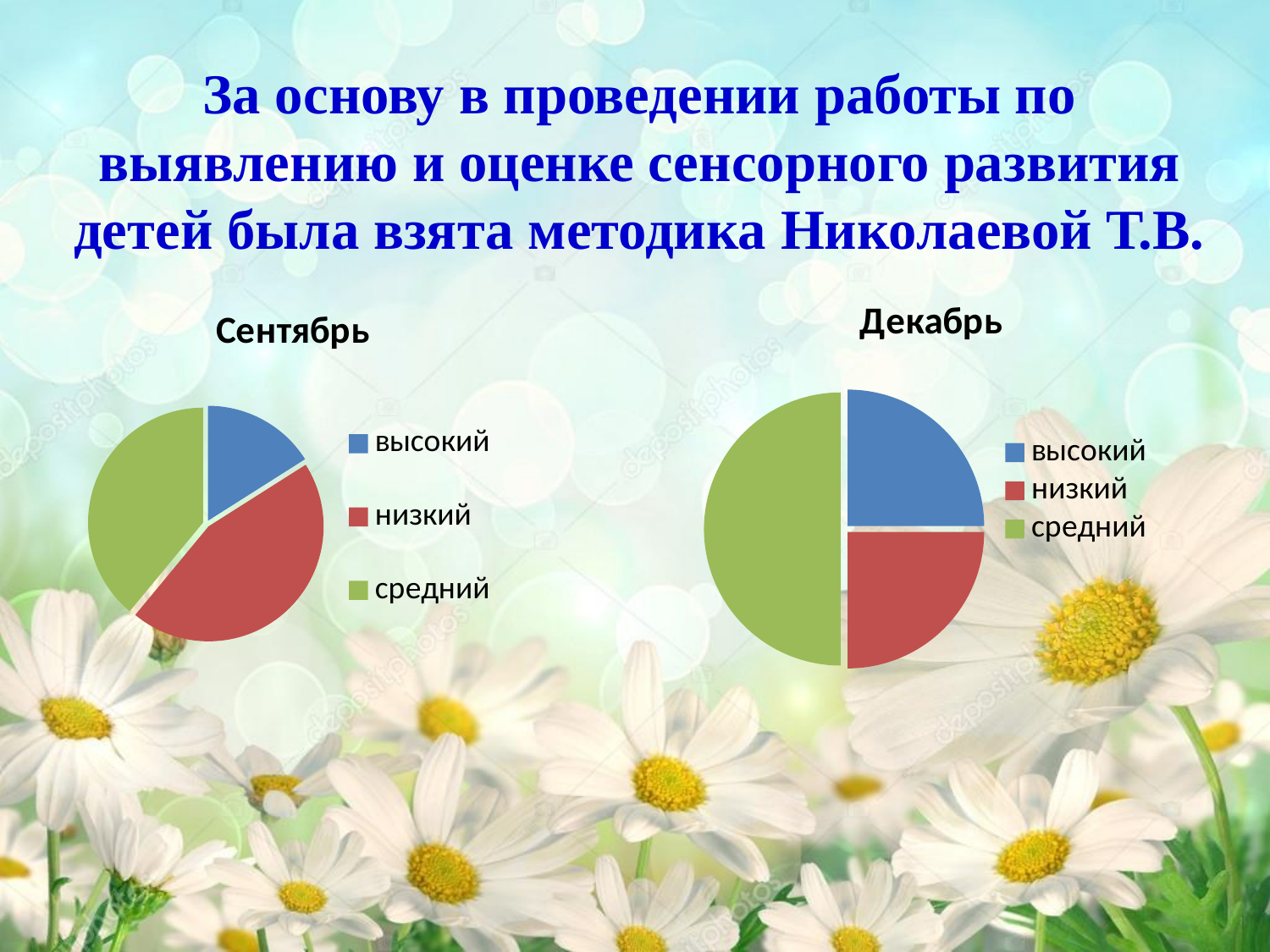
In the "Декабрь" chart, which category has the largest slice? средний How many entries does the legend of the "Декабрь" chart list? 3 How many slices does the "Сентябрь" pie chart have? 3 In the "Сентябрь" chart, which slice is larger: "средний" or "высокий"? средний What is the title of the pie chart on the left side of the slide? Сентябрь What kind of chart is the chart titled "Сентябрь"? pie chart What colour represents "низкий" in the "Декабрь" chart? red In the "Сентябрь" chart, which category has the smallest slice? высокий In the "Декабрь" chart, which slice is larger: "средний" or "высокий"? средний In the "Сентябрь" chart, which slice is larger: "высокий" or "низкий"? низкий What kind of chart is the chart titled "Декабрь"? pie chart